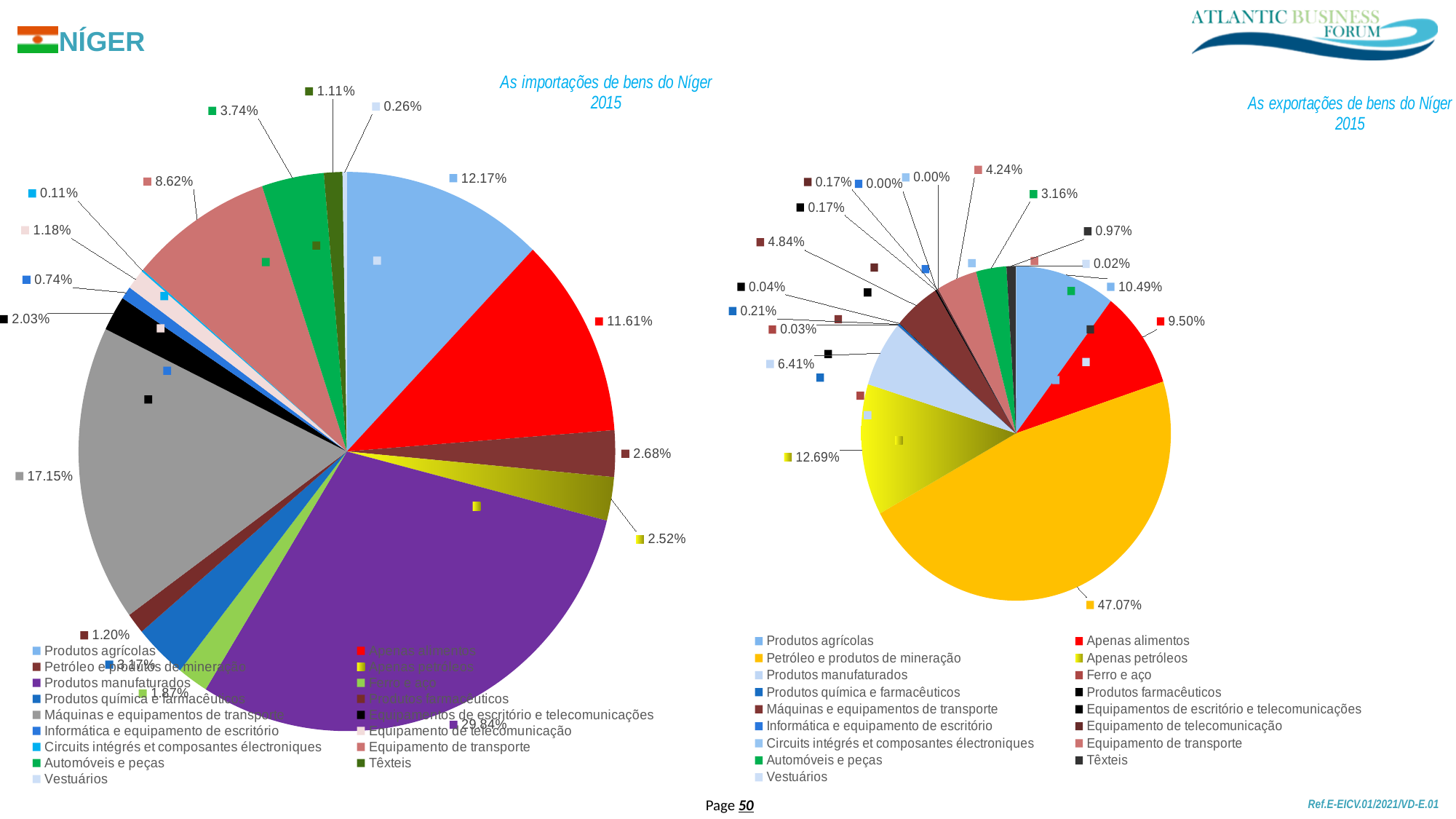
What kind of chart is 'As importações de bens do Níger 2015'? pie chart In the 'As exportações de bens do Níger 2015' chart, which category has the largest share? Petróleo e produtos de mineração How many categories does the legend of the 'As exportações de bens do Níger 2015' chart list? 17 In the 'As importações de bens do Níger 2015' chart, what is the share for Produtos manufaturados? 29.84% In the 'As exportações de bens do Níger 2015' chart, which is larger: Produtos agrícolas or Apenas alimentos? Produtos agrícolas In the 'As importações de bens do Níger 2015' chart, which category has the smallest share? Circuits intégrés et composantes électroniques In the 'As importações de bens do Níger 2015' chart, which category has the largest share? Produtos manufaturados In the 'As exportações de bens do Níger 2015' chart, what is the share for Petróleo e produtos de mineração? 47.07% In the 'As importações de bens do Níger 2015' chart, what is the difference between the shares for Produtos agrícolas and Apenas alimentos? 0.56% In the 'As exportações de bens do Níger 2015' chart, what is the share for Apenas petróleos? 12.69% In the 'As exportações de bens do Níger 2015' chart, what is the difference between the shares for Máquinas e equipamentos de transporte and Equipamento de transporte? 0.60% In the 'As importações de bens do Níger 2015' chart, what is the share for Máquinas e equipamentos de transporte? 17.15%